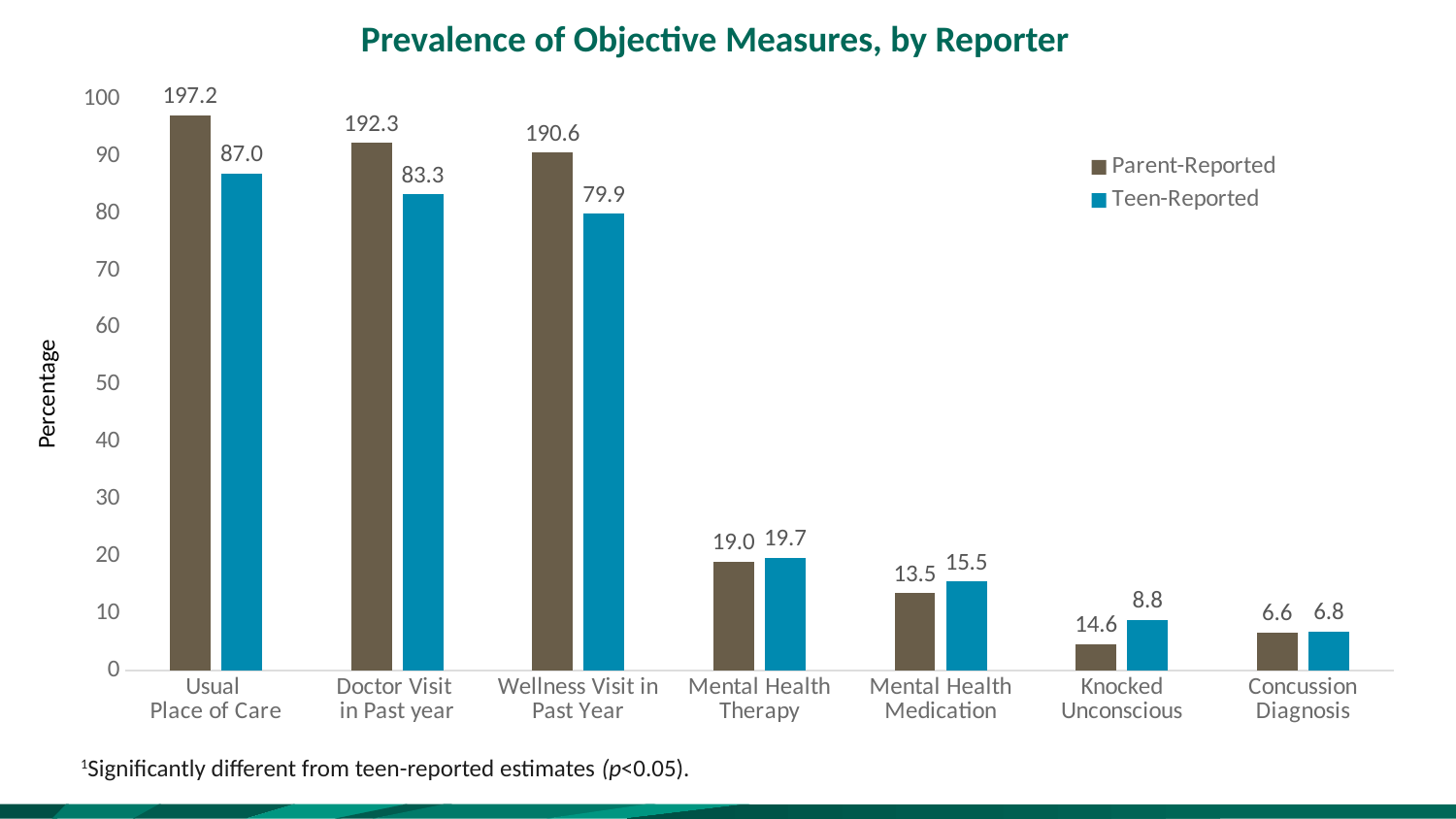
What is the Teen-Reported value for Mental Health Medication? 15.5 Which category has the highest Teen-Reported value? Usual Place of Care Is the Parent-Reported value for Usual Place of Care greater or less than 90? greater How many categories are shown on the x axis? 7 What is the Parent-Reported value for Concussion Diagnosis? 6.6 What is the Teen-Reported value for Doctor Visit in Past year? 83.3 What is the difference between the Teen-Reported values for Usual Place of Care and Doctor Visit in Past year? 3.7 Which category has the lowest Teen-Reported value? Concussion Diagnosis How many series does the legend list? 2 What is the Teen-Reported value for Usual Place of Care? 87.0 Which is larger: the Teen-Reported value for Wellness Visit in Past Year or for Mental Health Therapy? Wellness Visit in Past Year What kind of chart is shown on the slide? bar chart